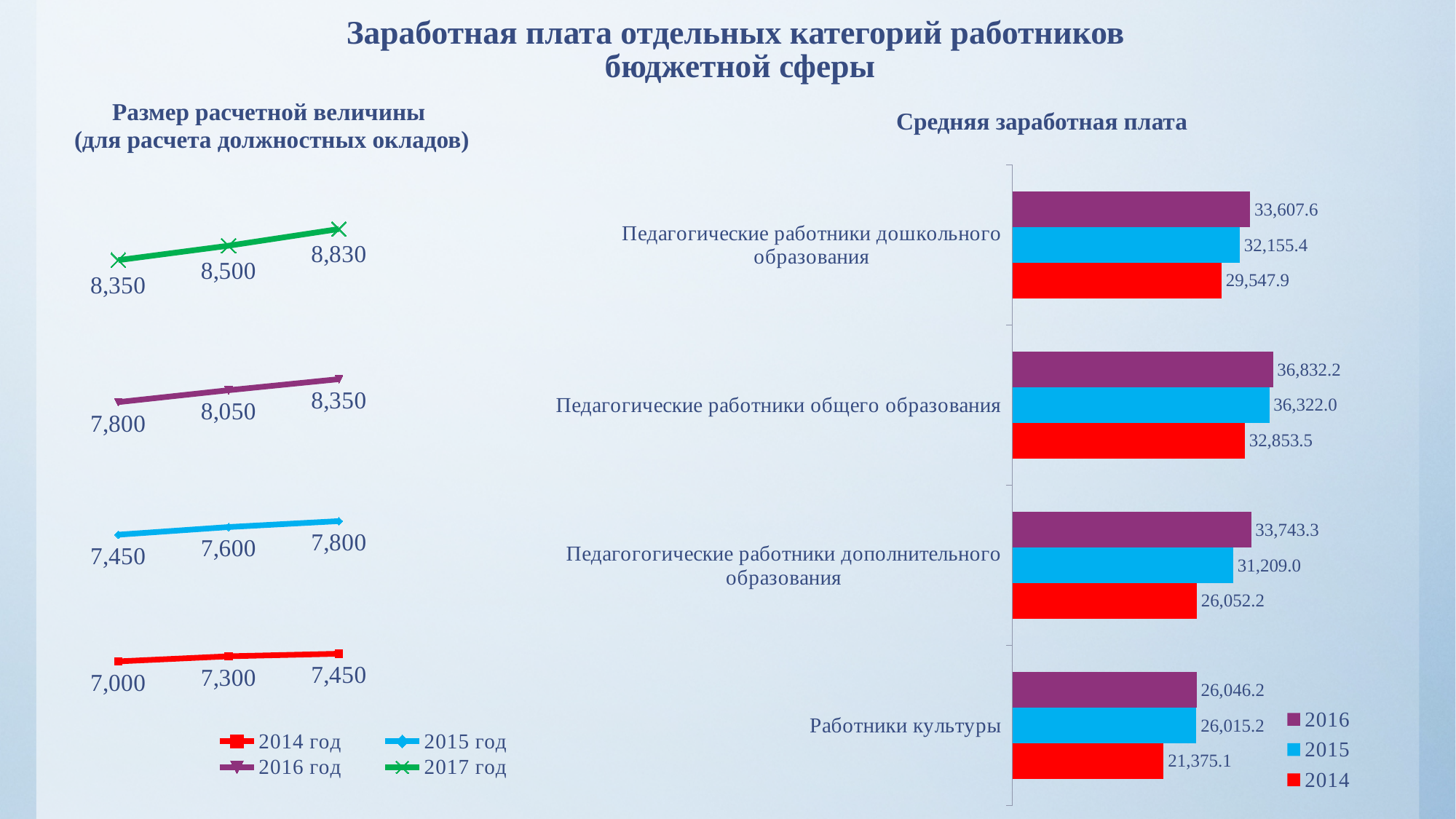
On the 'Средняя заработная плата' chart, how many categories are shown? 4 On the 'Средняя заработная плата' chart, what is the 2015 value for Педагогические работники дошкольного образования? 32,155.4 On the 'Средняя заработная плата' chart, how many series does the legend list? 3 On the 'Размер расчетной величины' chart, what is the last value of the 2017 год series? 8,830 On the 'Средняя заработная плата' chart, what is the difference between the 2016 and 2014 values for Педагогогические работники дополнительного образования? 7,691.1 On the 'Размер расчетной величины' chart, do the values of the 2014 год series rise or fall from left to right? Rise On the 'Средняя заработная плата' chart, which category has the lowest 2014 value? Работники культуры On the 'Средняя заработная плата' chart, what is the 2014 value for Работники культуры? 21,375.1 On the 'Средняя заработная плата' chart, which category has the highest 2016 value? Педагогические работники общего образования On the 'Средняя заработная плата' chart, what is the 2016 value for Педагогические работники общего образования? 36,832.2 What kind of chart is the 'Средняя заработная плата' chart? Bar chart On the 'Размер расчетной величины' chart, how many series does the legend list? 4